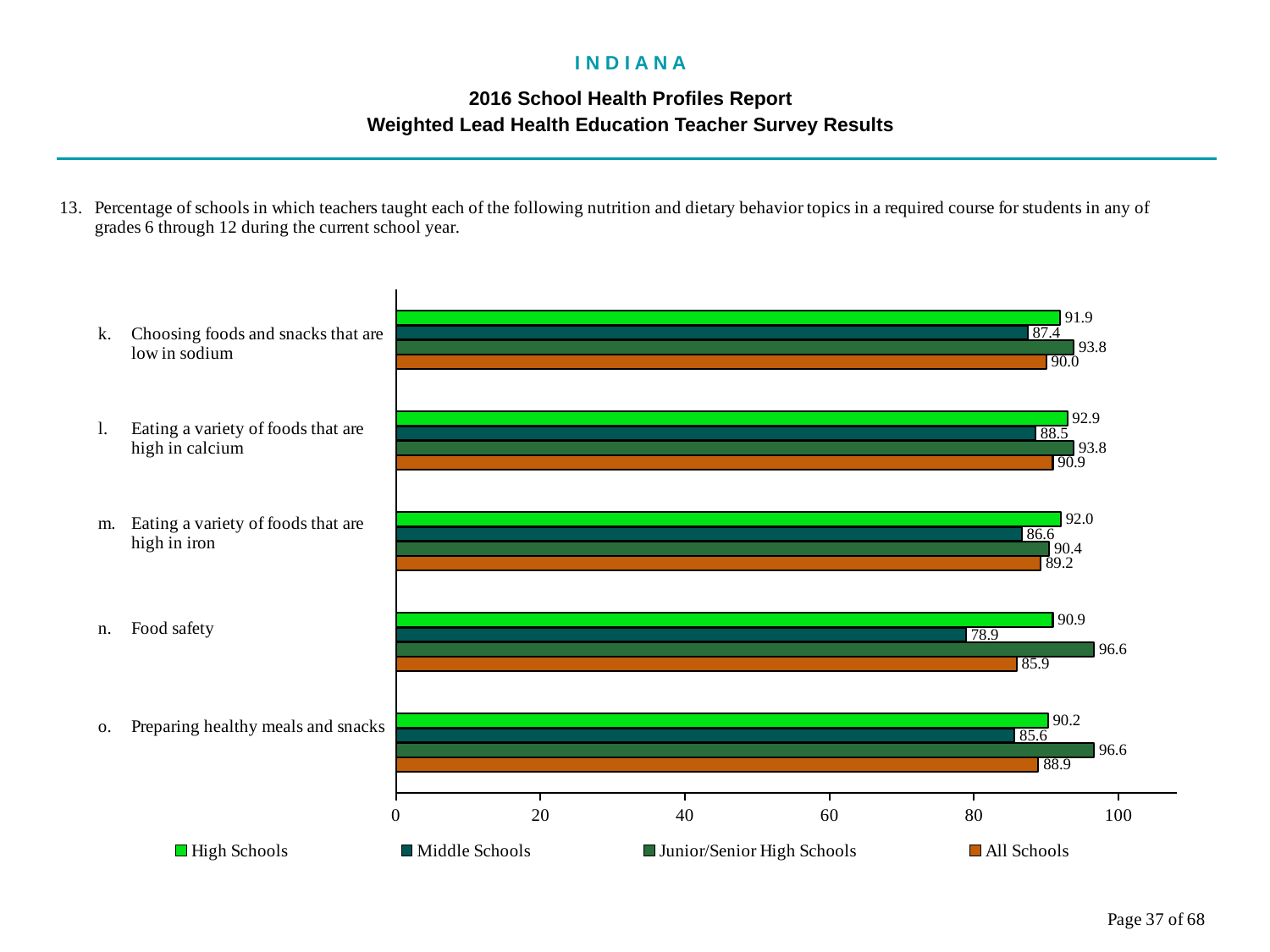
How many series does the legend list? 4 Which series is shown in orange in the legend? All Schools Which topic has the lowest value for Middle Schools? Food safety What is the value for All Schools for 'Eating a variety of foods that are high in calcium'? 90.9 What is the value for Junior/Senior High Schools for 'Preparing healthy meals and snacks'? 96.6 Which topic has the highest value for High Schools? Eating a variety of foods that are high in calcium How many topics (categories) are shown in the chart? 5 What kind of chart is shown on the slide? bar chart For 'Eating a variety of foods that are high in iron', which is larger: the High Schools value or the Junior/Senior High Schools value? High Schools What is the difference between the Junior/Senior High Schools and Middle Schools values for 'Food safety'? 17.7 What is the value for Middle Schools for 'Food safety'? 78.9 Is the Middle Schools value for 'Food safety' greater or less than 80? less